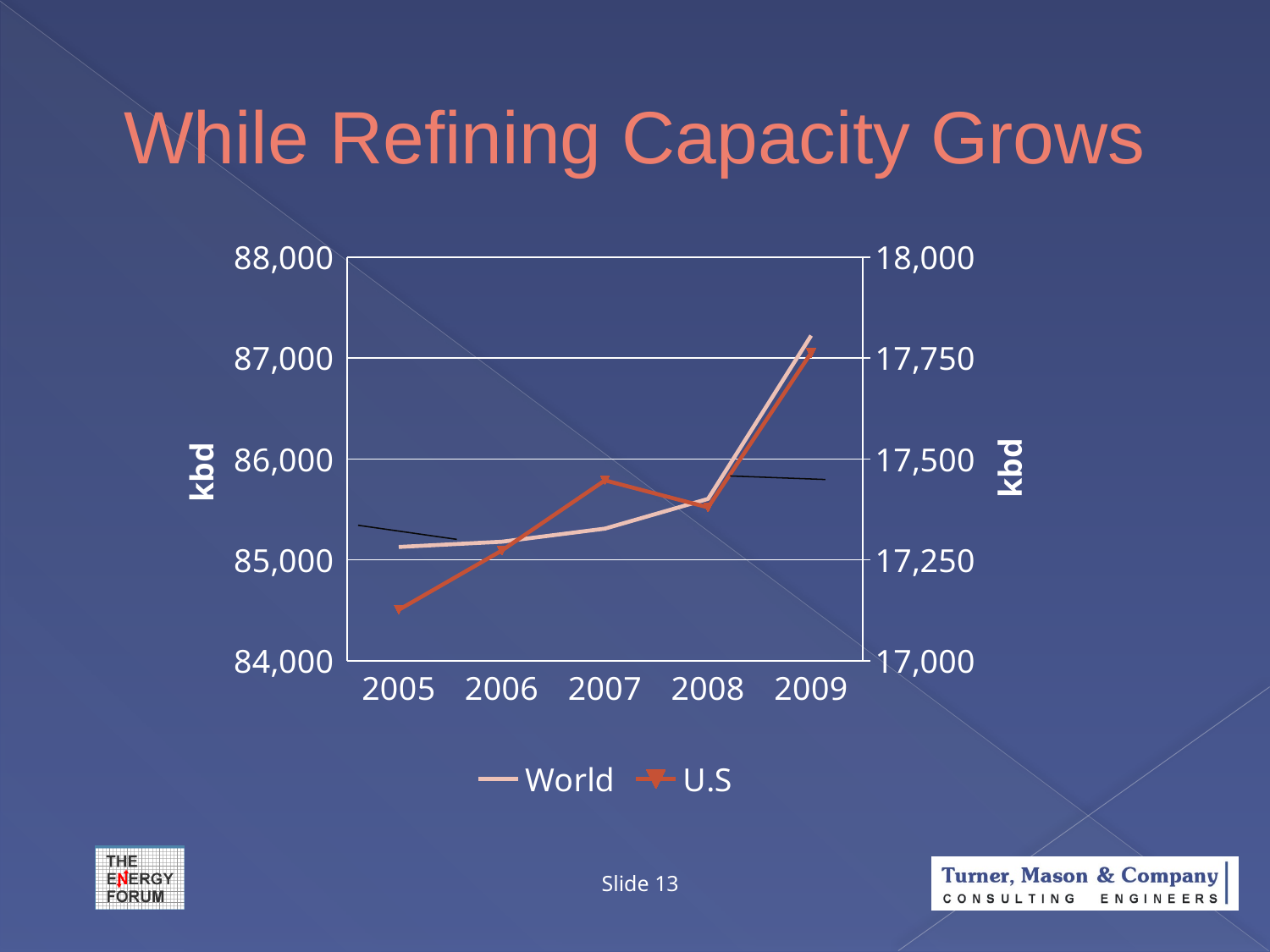
In which year is the U.S series at its highest? 2009 In which year is the World series at its highest? 2009 What kind of chart is shown on the slide? line chart How many years are plotted along the x axis? 5 In which year is the U.S series at its lowest? 2005 What is the title of the slide containing the chart? While Refining Capacity Grows Does the World series rise or fall from 2005 to 2009? rise How many series does the legend list? 2 Is the U.S value for 2005 greater or less than 17,250? less Is the World value for 2009 greater or less than 87,000? greater Is the U.S value for 2007 greater or less than 17,500? less Which is larger for the U.S series, the value for 2007 or the value for 2008? 2007